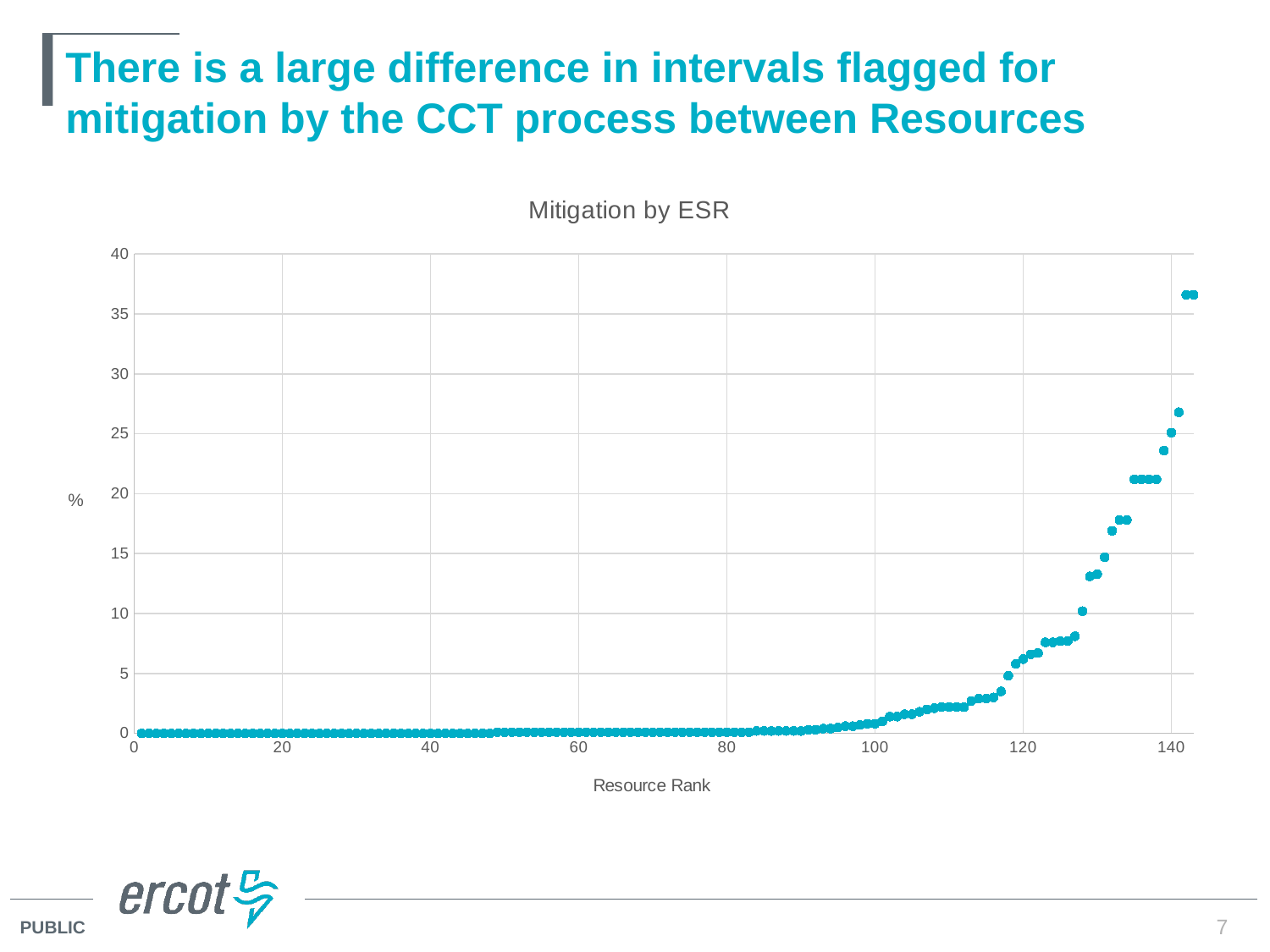
What is the title of the chart? Mitigation by ESR What is the label of the x axis of the chart? Resource Rank Which has the larger value: the point at Resource Rank 20 or the point at Resource Rank 120? Resource Rank 120 Are the highest values on the chart found at the lowest or the highest Resource Ranks? Highest Resource Ranks Is the highest plotted value on the chart greater or less than 35? greater Is the value at Resource Rank 60 greater or less than 5? less Is the value at Resource Rank 130 greater or less than 10? greater Do the plotted values rise or fall as Resource Rank increases along the x axis? Rise What kind of chart is shown on the slide? Scatter chart